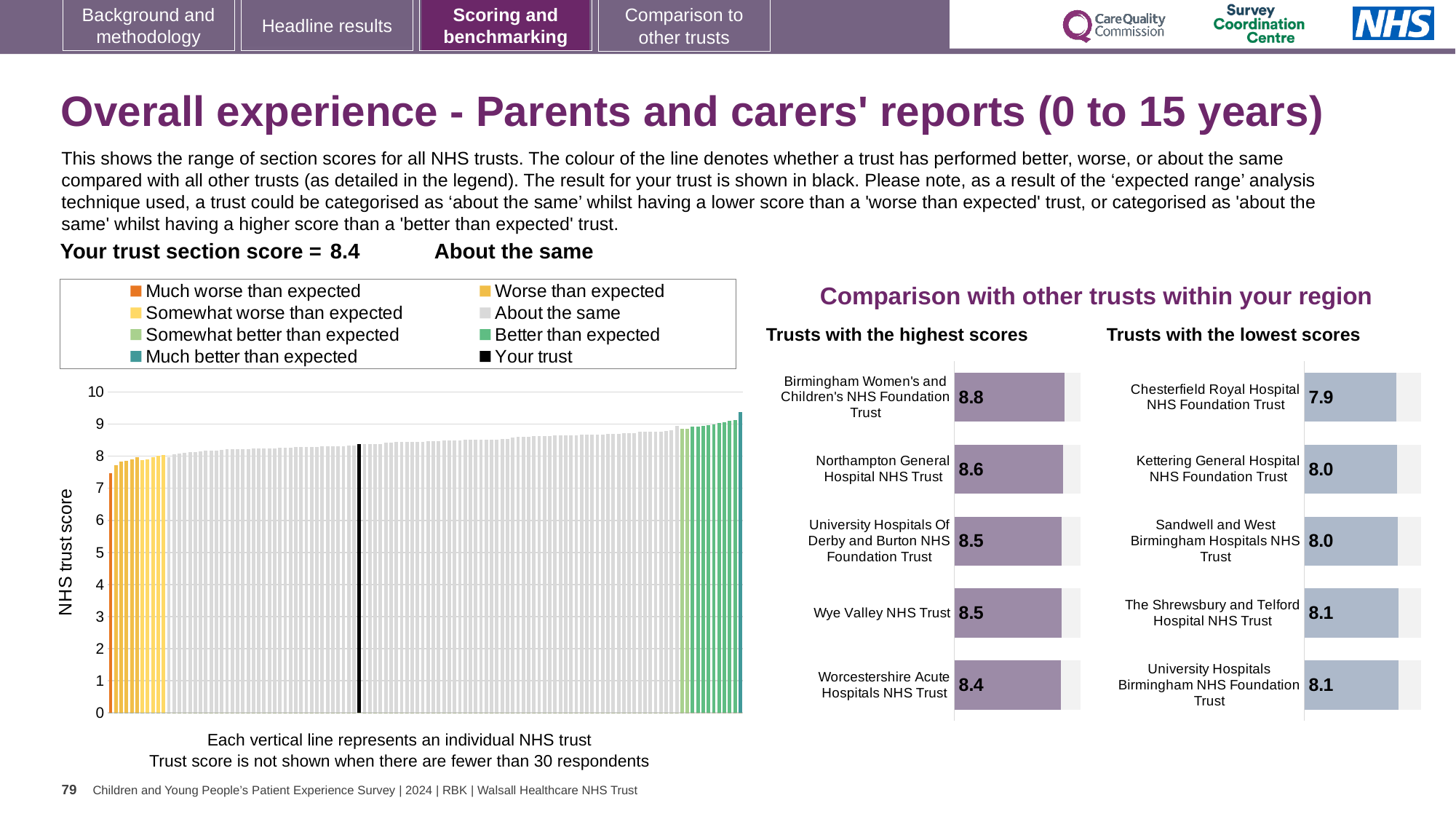
In the 'Trusts with the highest scores' chart, what is the difference between the scores of Birmingham Women's and Children's NHS Foundation Trust and Worcestershire Acute Hospitals NHS Trust? 0.4 In the main chart on the left showing the range of section scores, is the value for your trust (the black line) greater or less than 8? greater In the 'Trusts with the lowest scores' chart, what is the score for The Shrewsbury and Telford Hospital NHS Trust? 8.1 How many entries does the legend of the main chart on the left list? 8 In the 'Trusts with the lowest scores' chart, which has the larger score: Chesterfield Royal Hospital NHS Foundation Trust or Kettering General Hospital NHS Foundation Trust? Kettering General Hospital NHS Foundation Trust In the 'Trusts with the highest scores' chart, how many trusts are listed? 5 In the 'Trusts with the highest scores' chart, what is the score for Northampton General Hospital NHS Trust? 8.6 In the 'Trusts with the lowest scores' chart, which trust has the lowest score? Chesterfield Royal Hospital NHS Foundation Trust In the 'Trusts with the highest scores' chart, which trust has the highest score? Birmingham Women's and Children's NHS Foundation Trust In the 'Trusts with the highest scores' chart, what is the score for Birmingham Women's and Children's NHS Foundation Trust? 8.8 In the 'Trusts with the lowest scores' chart, what is the score for Chesterfield Royal Hospital NHS Foundation Trust? 7.9 In the main chart on the left, do the trust scores rise or fall from left to right along the x axis? rise